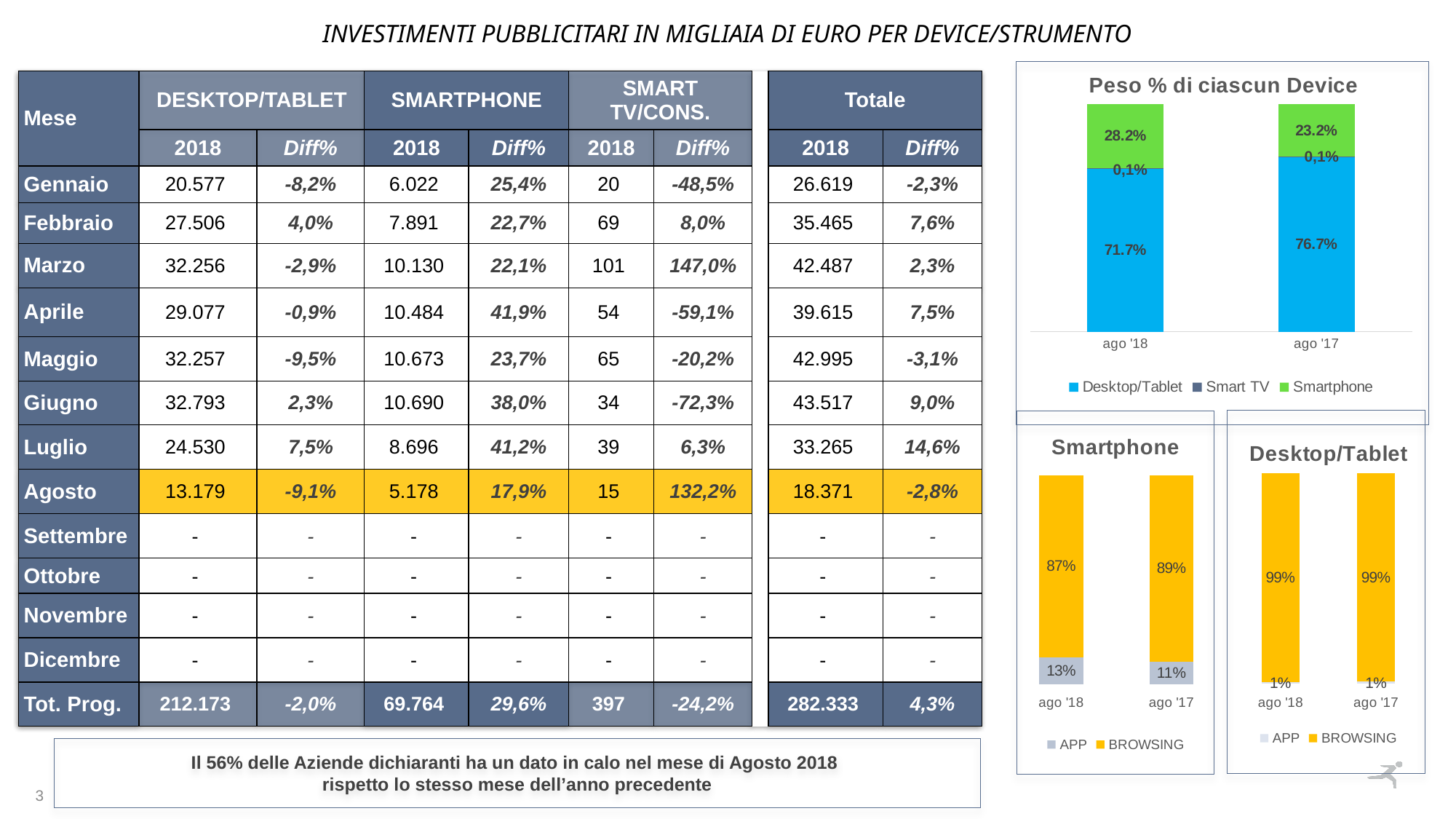
In the 'Peso % di ciascun Device' chart, what is the share for Smartphone in ago '17? 23.2% In the 'Peso % di ciascun Device' chart, what is the share for Desktop/Tablet in ago '18? 71.7% In the 'Desktop/Tablet' chart, what is the BROWSING share for ago '18? 99% What kind of chart is 'Peso % di ciascun Device'? Stacked bar chart How many series does the legend of the 'Peso % di ciascun Device' chart list? 3 In the 'Smartphone' chart, what is the difference between the APP share in ago '18 and in ago '17? 2 percentage points In the 'Peso % di ciascun Device' chart, by how many percentage points does the Smartphone share in ago '18 exceed that in ago '17? 5.0 percentage points What are the two legend entries of the 'Desktop/Tablet' chart? APP and BROWSING In the 'Smartphone' chart, what is the BROWSING share for ago '17? 89% How many categories are shown on the x axis of the 'Smartphone' chart? 2 In the 'Peso % di ciascun Device' chart, is the Desktop/Tablet share larger in ago '18 or ago '17? ago '17 In the 'Smartphone' chart, what is the APP share for ago '18? 13%